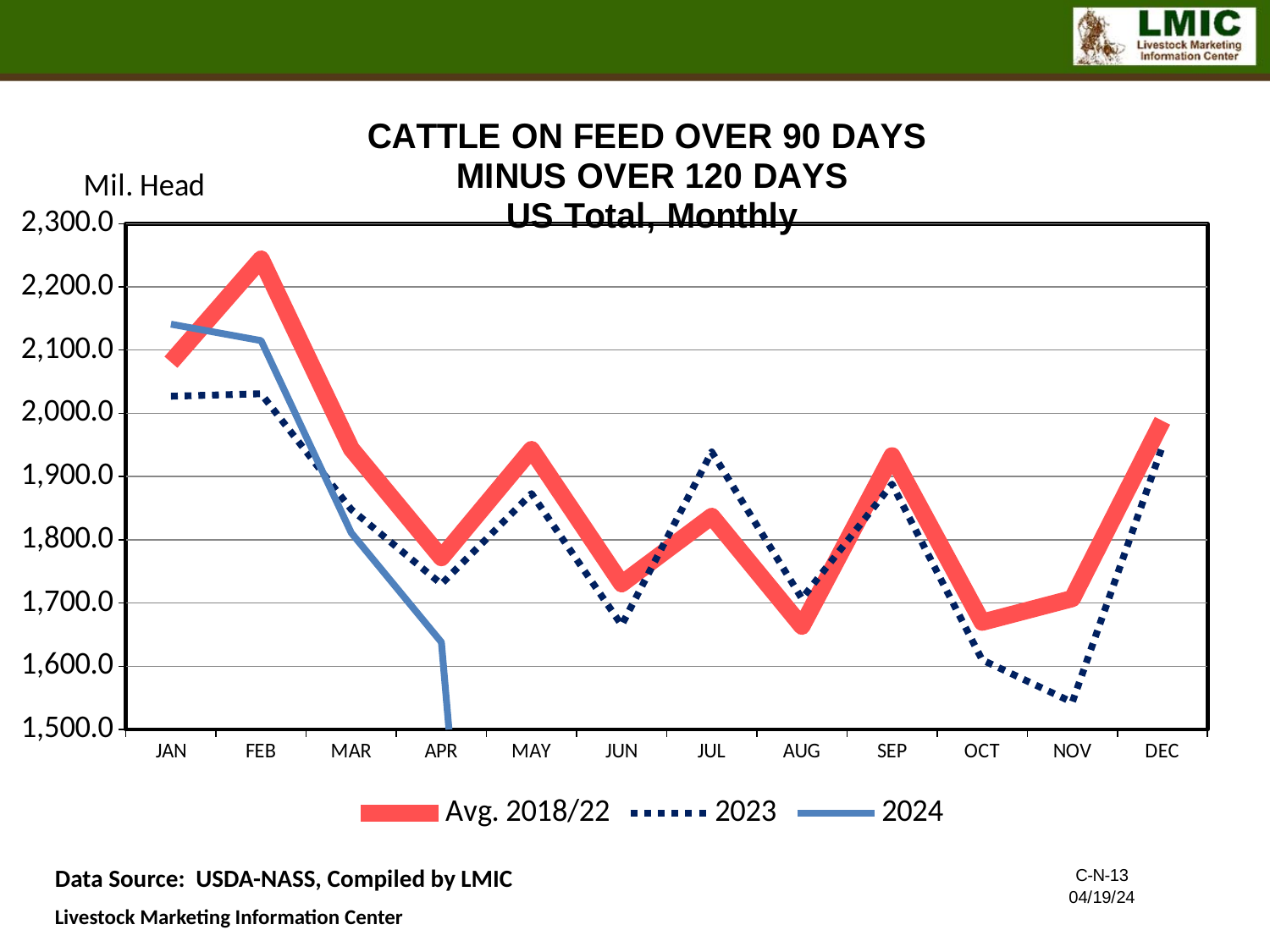
How many series does the legend list? 3 What kind of chart is shown on the slide? Line chart In FEB, which series has the larger value, Avg. 2018/22 or 2023? Avg. 2018/22 Is the 2023 value for NOV greater or less than 1,600.0? less How many months are shown along the x axis? 12 Is the Avg. 2018/22 value for FEB greater or less than 2,200.0? greater In which month does the Avg. 2018/22 series reach its highest value? FEB Does the 2024 series rise or fall from JAN to APR? Fall In JUL, which series has the larger value, 2023 or Avg. 2018/22? 2023 Is the Avg. 2018/22 value for AUG greater or less than 1,700.0? less In which month does the 2023 series reach its lowest value? NOV